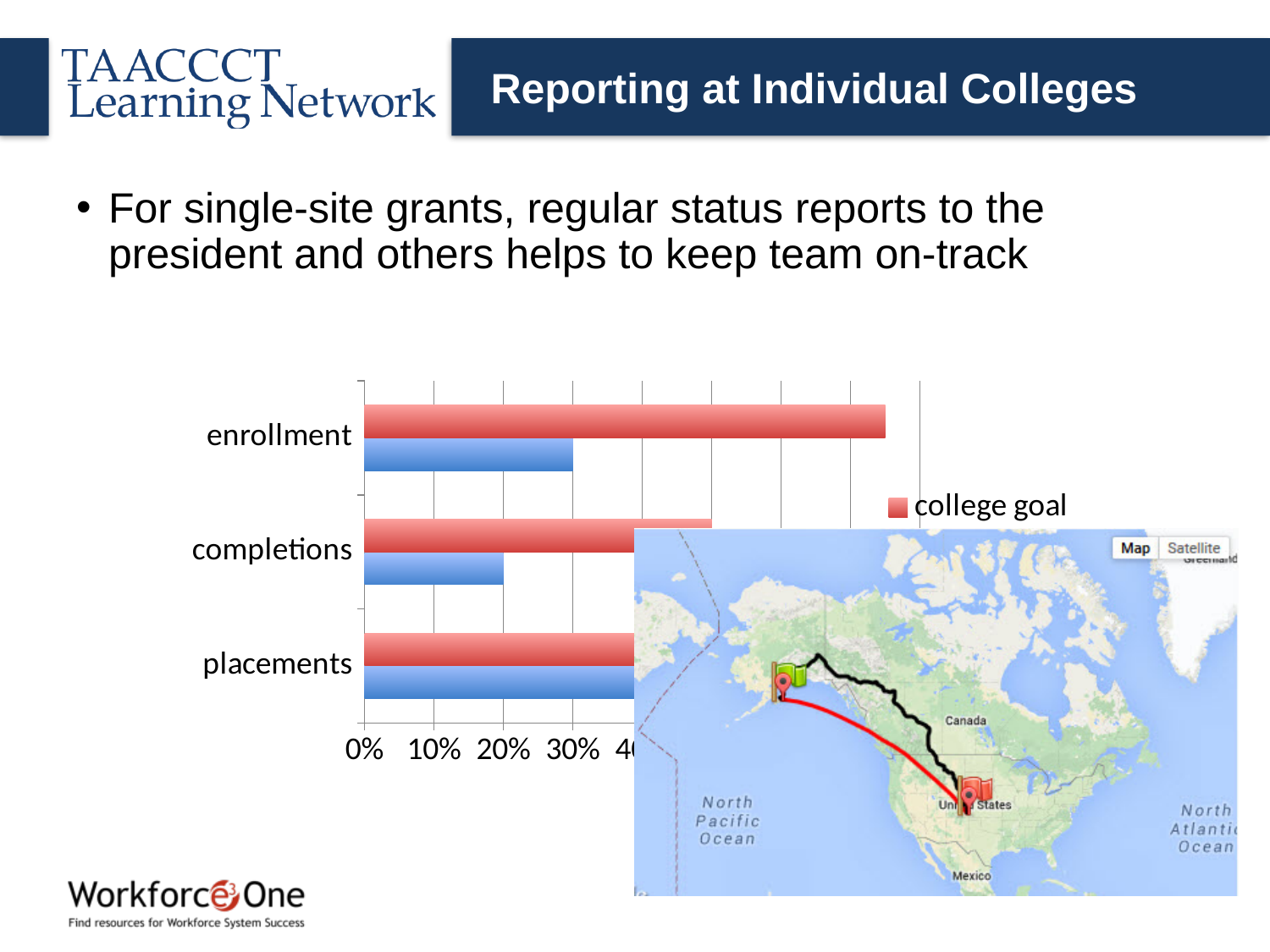
Which has the larger blue bar, enrollment or completions? enrollment Is the college goal value for completions greater or less than 40%? greater Is the college goal value for enrollment greater or less than 40%? greater What is the difference between the blue bar for enrollment and the blue bar for completions? 10% How many bars are plotted for each category in the bar chart? 2 What value does the blue bar for completions reach in the bar chart? 20% How many categories are listed on the vertical axis of the bar chart? 3 Which category has the larger college goal value, enrollment or completions? enrollment For enrollment, which bar is longer: the college goal bar or the blue bar? college goal What colour represents the college goal series in the legend? red What value does the blue bar for enrollment reach in the bar chart? 30% What kind of chart is shown on the slide? bar chart